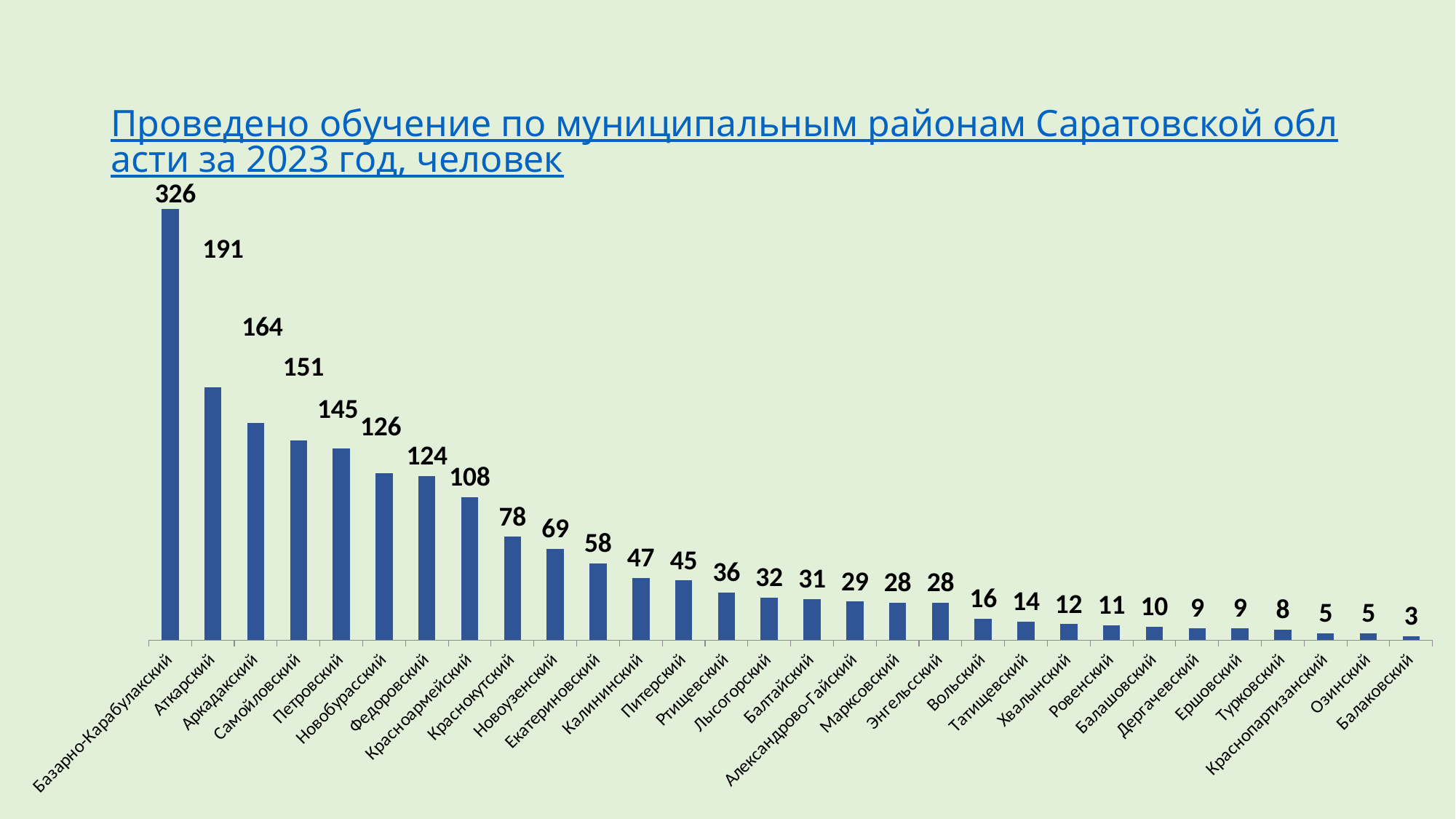
What type of chart is shown on the slide? bar chart Which district has the highest value? Базарно-Карабулакский How many districts are shown on the chart? 30 What is the difference between the values for Краснокутский and Новоузенский? 9 What is the value for Энгельсский? 28 What is the title of the chart? Проведено обучение по муниципальным районам Саратовской области за 2023 год, человек What is the value for Красноармейский? 108 What is the value for Аткарский? 191 What is the difference between the values for Базарно-Карабулакский and Аткарский? 135 Do the values rise or fall from left to right along the x axis? fall Which is larger, the value for Самойловский or the value for Петровский? Самойловский Which district has the lowest value? Балаковский